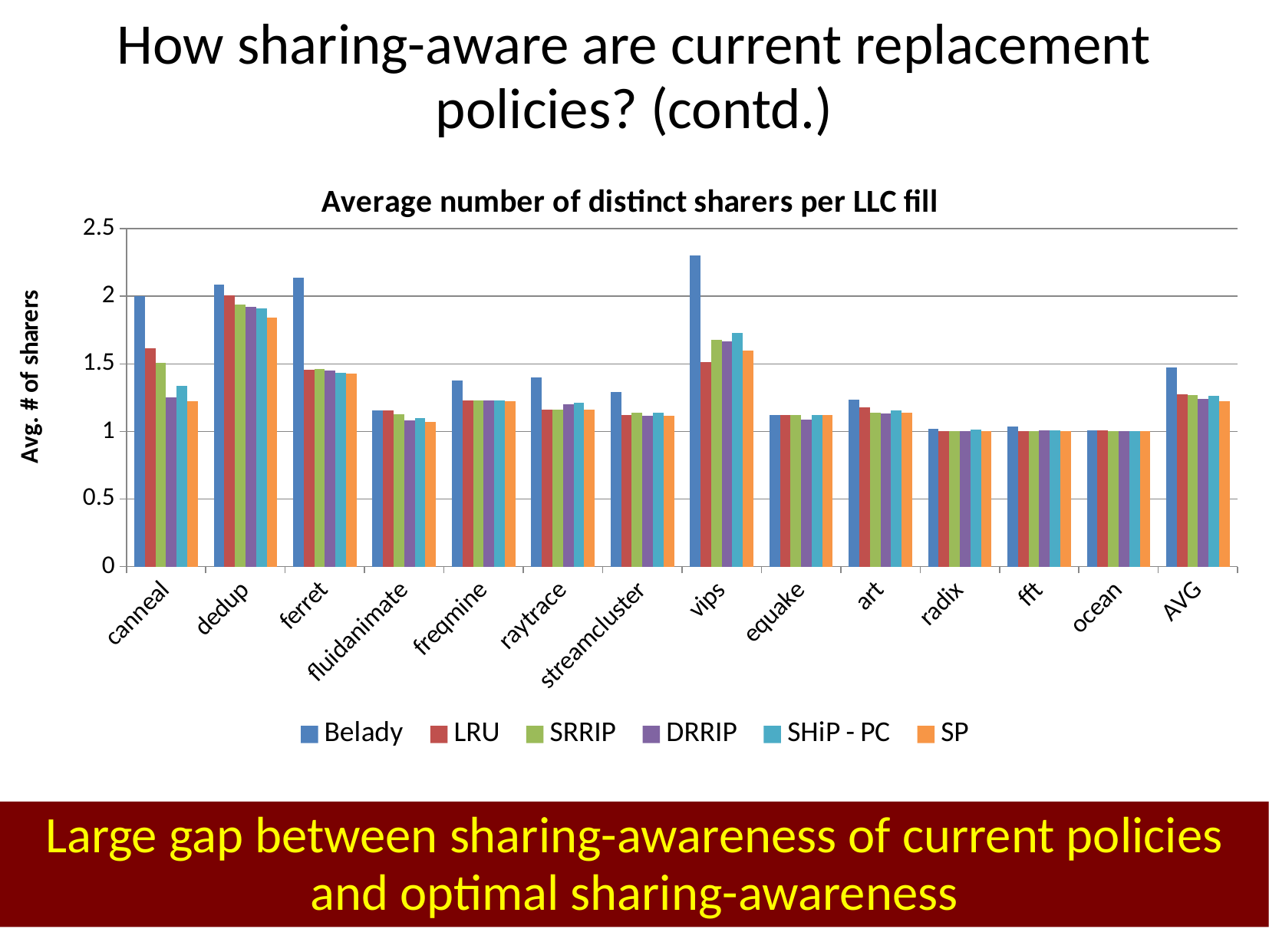
How many series does the legend list? 6 Is the Belady value for vips greater or less than 2? greater What kind of chart is shown on the slide? bar chart For which category is the Belady bar the highest? vips How many categories are shown on the x axis? 14 Is the SP value for dedup greater or less than 1.5? greater What is the title of the chart? Average number of distinct sharers per LLC fill Which series has the highest value for AVG? Belady For canneal, which is larger: the Belady value or the LRU value? Belady Is the LRU value for canneal greater or less than 1.5? greater What is the label of the y axis? Avg. # of sharers